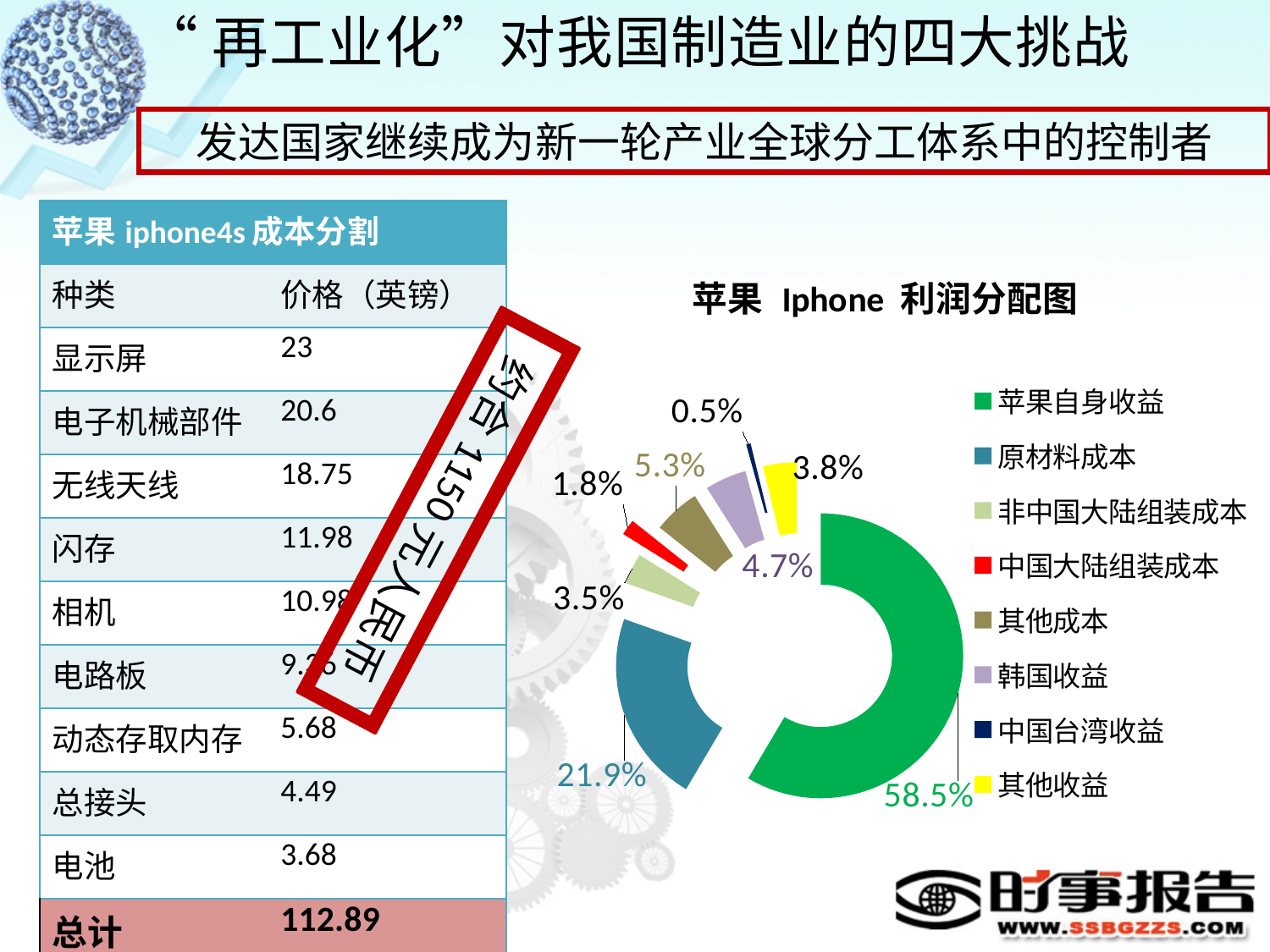
What share of the chart is 中国台湾收益? 0.5% What is the difference between the shares of 苹果自身收益 and 原材料成本? 36.6% How many categories does the legend of the chart list? 8 Which category has the smallest share in the chart? 中国台湾收益 What share of the chart is 苹果自身收益? 58.5% Which category has the largest share in the chart? 苹果自身收益 What share of the chart is 韩国收益? 4.7% What kind of chart is shown on the slide? doughnut (pie) chart What share of the chart is 原材料成本? 21.9% What colour is the slice for 中国大陆组装成本? red What is the title of the chart on the slide? 苹果 Iphone 利润分配图 Which is larger, the share of 其他成本 or the share of 其他收益? 其他成本